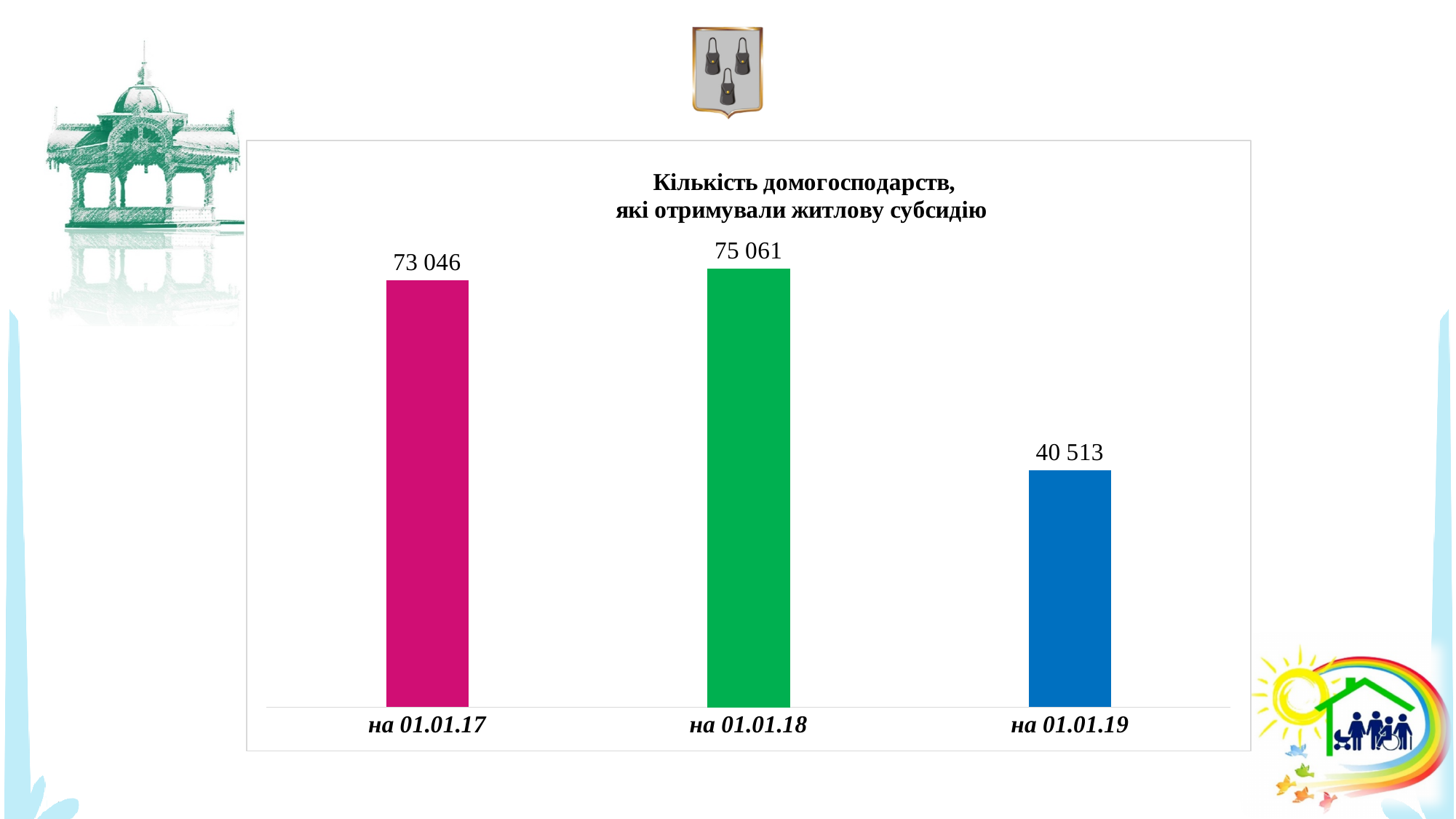
How many categories are shown on the chart? 3 What is the value for на 01.01.17? 73 046 Which category has the highest value? на 01.01.18 Which is larger, the value for на 01.01.17 or the value for на 01.01.19? на 01.01.17 What kind of chart is shown on the slide? bar chart What is the difference between the values for на 01.01.18 and на 01.01.17? 2 015 What is the difference between the values for на 01.01.18 and на 01.01.19? 34 548 Which category has the lowest value? на 01.01.19 What colour is the bar for на 01.01.19? blue What is the title of the chart? Кількість домогосподарств, які отримували житлову субсидію What is the value for на 01.01.18? 75 061 What is the value for на 01.01.19? 40 513